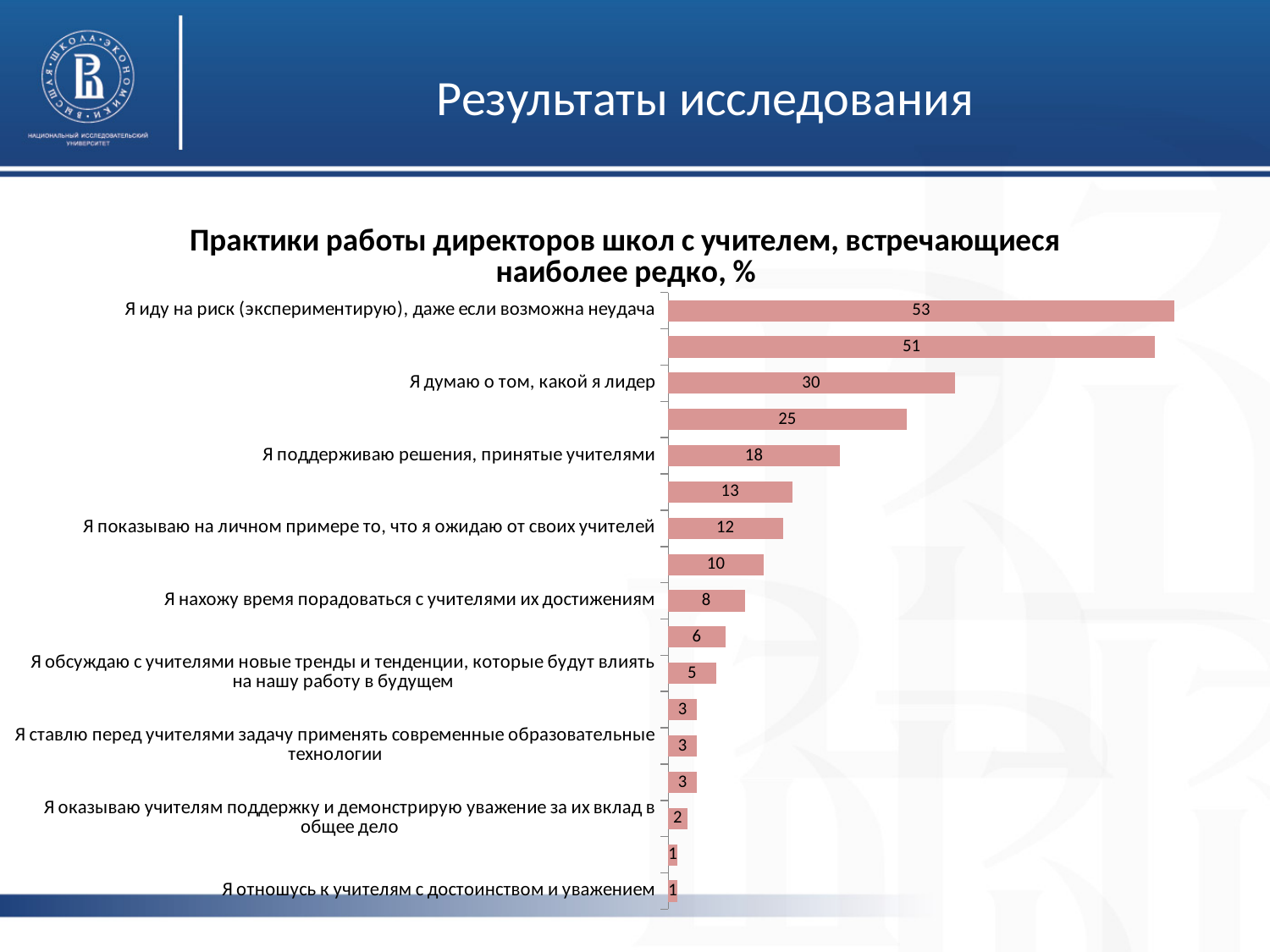
What type of chart is shown on the slide? bar chart What is the value for "Я иду на риск (экспериментирую), даже если возможна неудача"? 53 What is the value for "Я поддерживаю решения, принятые учителями"? 18 What is the value for "Я нахожу время порадоваться с учителями их достижениям"? 8 Which is larger: the value for "Я показываю на личном примере то, что я ожидаю от своих учителей" or for "Я обсуждаю с учителями новые тренды и тенденции, которые будут влиять на нашу работу в будущем"? Я показываю на личном примере то, что я ожидаю от своих учителей Do the bar values increase or decrease from the top of the chart to the bottom? decrease Which category has the highest value? Я иду на риск (экспериментирую), даже если возможна неудача What is the title of the chart? Практики работы директоров школ с учителем, встречающиеся наиболее редко, % How many bars are plotted in the chart? 17 What is the difference between the values for "Я иду на риск (экспериментирую), даже если возможна неудача" and "Я думаю о том, какой я лидер"? 23 What is the value for "Я отношусь к учителям с достоинством и уважением"? 1 What is the value for "Я думаю о том, какой я лидер"? 30